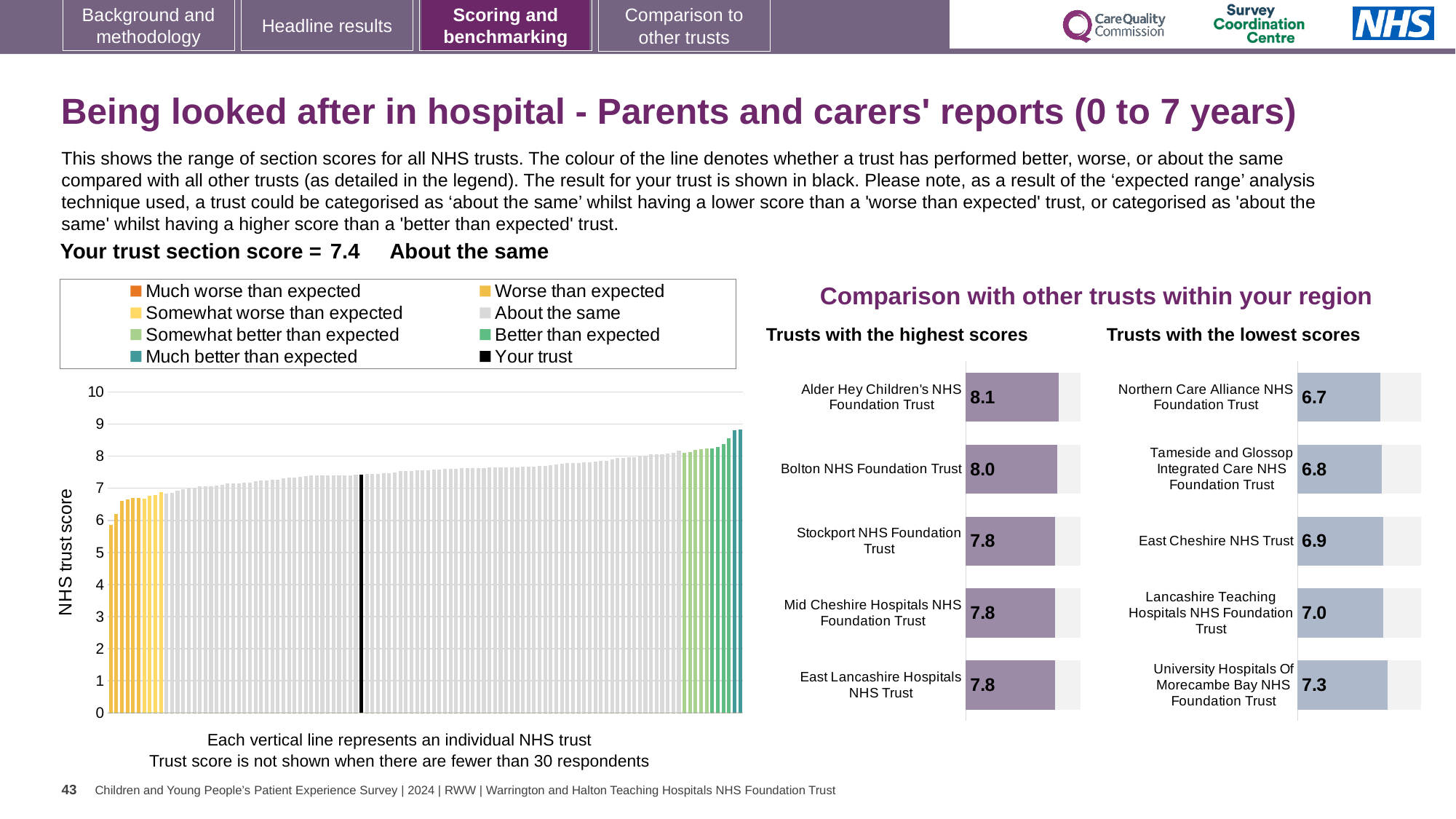
What is the difference between Alder Hey Children's NHS Foundation Trust's score in the highest-scores chart and Northern Care Alliance NHS Foundation Trust's score in the lowest-scores chart? 1.4 In the 'Trusts with the lowest scores' chart, what is the score for University Hospitals Of Morecambe Bay NHS Foundation Trust? 7.3 In the 'Trusts with the highest scores' chart, what is the score for Bolton NHS Foundation Trust? 8.0 In the 'Trusts with the highest scores' chart, which trust has the highest score? Alder Hey Children's NHS Foundation Trust In the 'Trusts with the highest scores' chart, what is the score for Alder Hey Children's NHS Foundation Trust? 8.1 In the 'Trusts with the lowest scores' chart, which trust has the lowest score? Northern Care Alliance NHS Foundation Trust How many entries does the legend above the 'NHS trust score' chart list? 8 In the large 'NHS trust score' chart on the left, do the values rise or fall from left to right? Rise What kind of chart is the large 'NHS trust score' chart on the left? Bar chart How many trusts are shown in the 'Trusts with the highest scores' chart? 5 In the 'Trusts with the lowest scores' chart, which has the larger score: East Cheshire NHS Trust or Lancashire Teaching Hospitals NHS Foundation Trust? Lancashire Teaching Hospitals NHS Foundation Trust In the 'Trusts with the lowest scores' chart, what is the score for Northern Care Alliance NHS Foundation Trust? 6.7